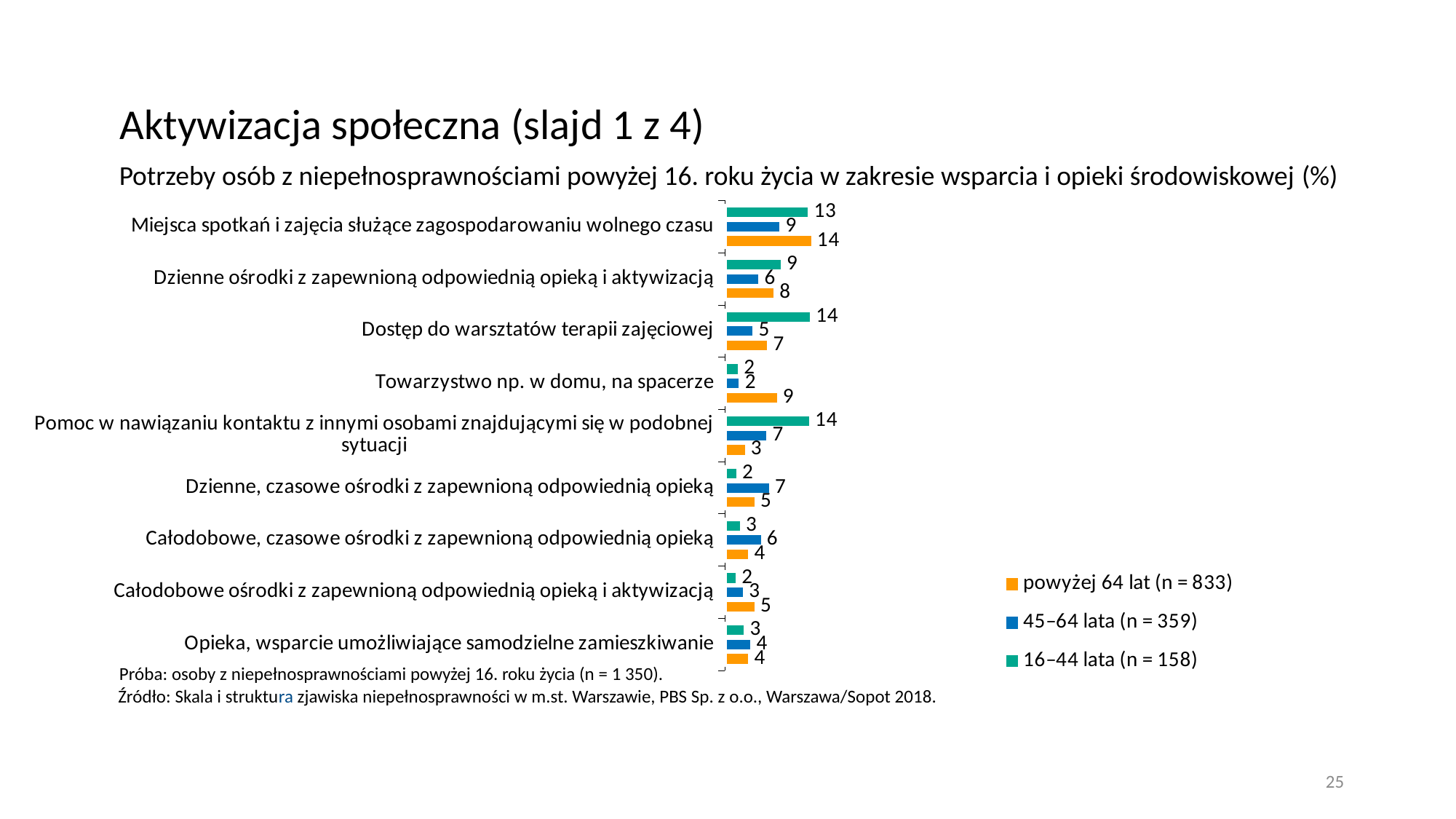
What kind of chart is shown on the slide? Bar chart How many series does the legend list? 3 For 'Dzienne ośrodki z zapewnioną odpowiednią opieką i aktywizacją', which series has the larger value: '16–44 lata (n = 158)' or '45–64 lata (n = 359)'? 16–44 lata (n = 158) What is the value for 'Towarzystwo np. w domu, na spacerze' in the 'powyżej 64 lat (n = 833)' series? 9 Which category has the highest value in the 'powyżej 64 lat (n = 833)' series? Miejsca spotkań i zajęcia służące zagospodarowaniu wolnego czasu Which colour represents the '45–64 lata (n = 359)' series? Blue What is the difference between the '16–44 lata (n = 158)' and 'powyżej 64 lat (n = 833)' values for 'Pomoc w nawiązaniu kontaktu z innymi osobami znajdującymi się w podobnej sytuacji'? 11 What is the value for 'Dzienne, czasowe ośrodki z zapewnioną odpowiednią opieką' in the '45–64 lata (n = 359)' series? 7 How many categories are shown on the chart? 9 Which category has the lowest value in the 'powyżej 64 lat (n = 833)' series? Pomoc w nawiązaniu kontaktu z innymi osobami znajdującymi się w podobnej sytuacji What is the value for 'Dostęp do warsztatów terapii zajęciowej' in the '16–44 lata (n = 158)' series? 14 Which category has the lowest value in the '45–64 lata (n = 359)' series? Towarzystwo np. w domu, na spacerze